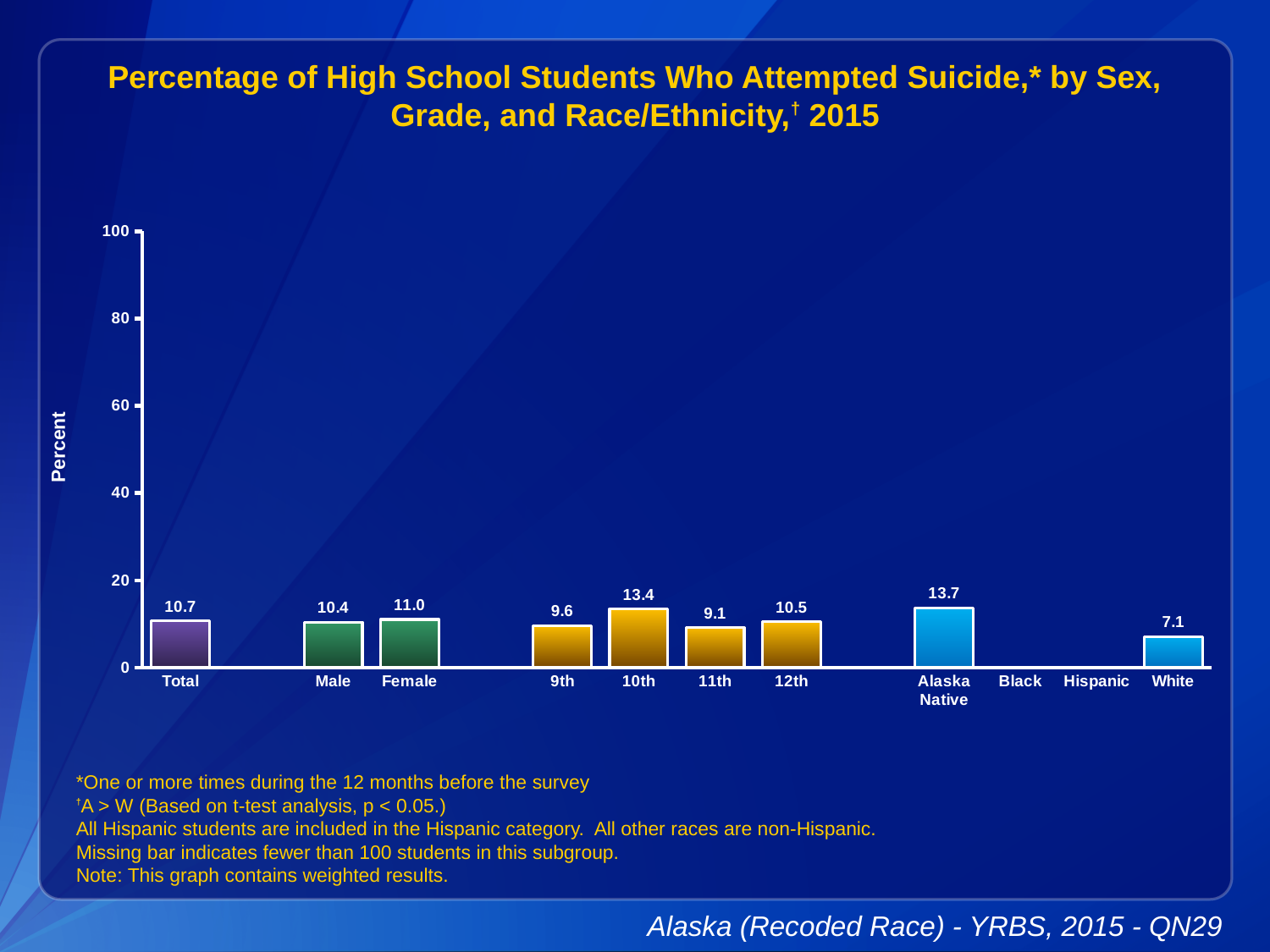
What is the difference between the Female and Male values? 0.6 Which is larger, the value for 10th grade or the value for 11th grade? 10th What is the label on the y axis? Percent What kind of chart is this? bar chart What is the value for Total? 10.7 Which category has the lowest value among those with a bar shown? White What is the value for Female? 11.0 What is the value for White? 7.1 Which grade has the highest value? 10th What is the value for Alaska Native? 13.7 Is the value for Alaska Native greater or less than 20? less How many categories on the x axis have no bar shown? 2